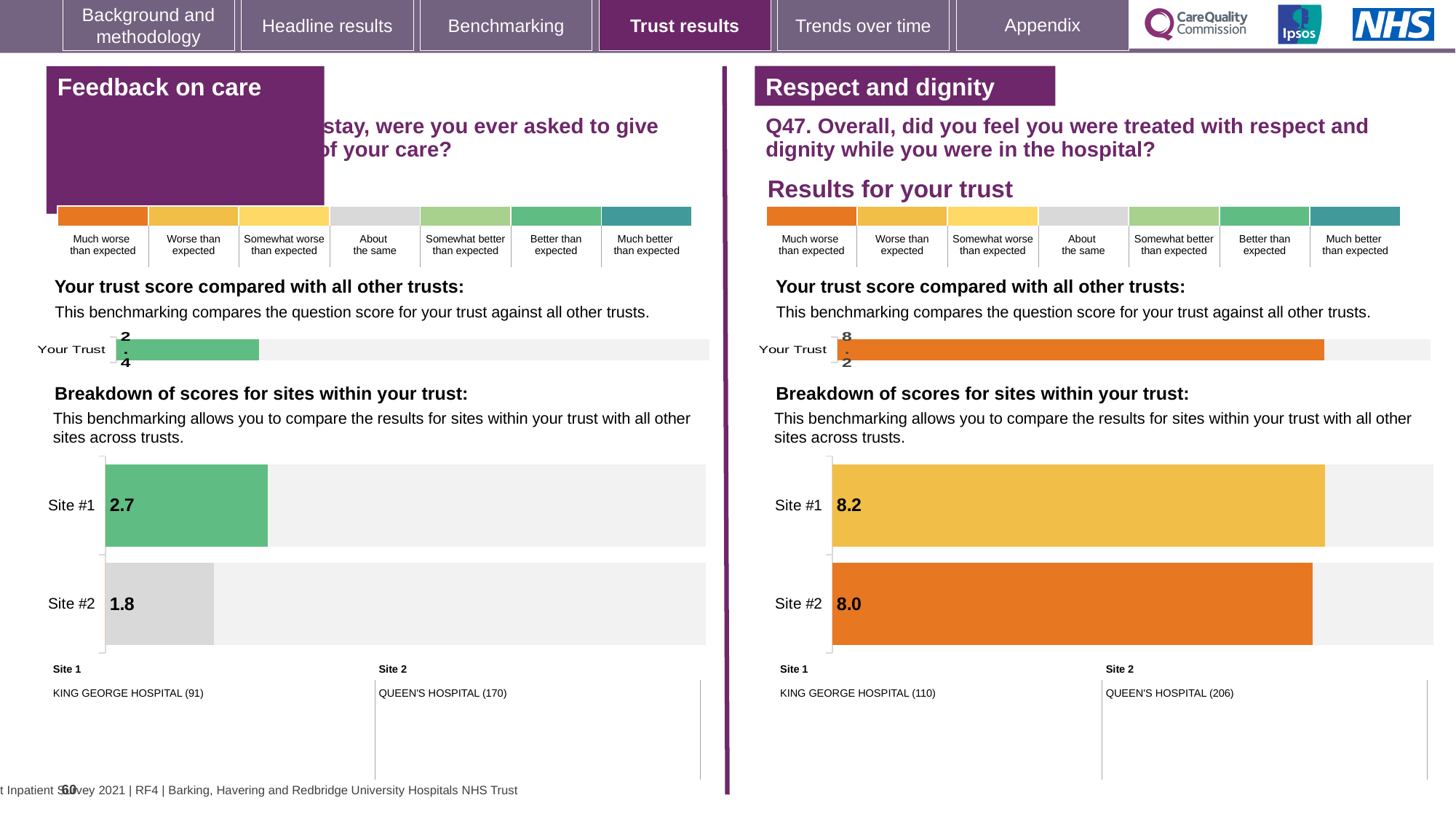
In the Respect and dignity section, what is the score shown for Site #2 in the breakdown of scores for sites within your trust? 8.0 In the Feedback on care site breakdown chart, which site has the higher score? Site #1 In the Respect and dignity section, what is the score shown for Your Trust in the chart comparing your trust score with all other trusts? 8.2 In the Feedback on care section, what is the score shown for Site #1 in the breakdown of scores for sites within your trust? 2.7 In the Feedback on care site breakdown chart, what is the difference between the Site #1 and Site #2 scores? 0.9 In the Respect and dignity section, what is the score shown for Site #1 in the breakdown of scores for sites within your trust? 8.2 In the Respect and dignity site breakdown chart, which site has the lower score? Site #2 In the Feedback on care section, what is the score shown for Site #2 in the breakdown of scores for sites within your trust? 1.8 What type of chart is used for the breakdown of scores for sites within your trust in the Respect and dignity section? Bar chart In the Feedback on care section, what is the score shown for Your Trust in the chart comparing your trust score with all other trusts? 2.4 In the Respect and dignity site breakdown chart, what is the difference between the Site #1 and Site #2 scores? 0.2 How many sites are shown in the Feedback on care site breakdown chart? 2